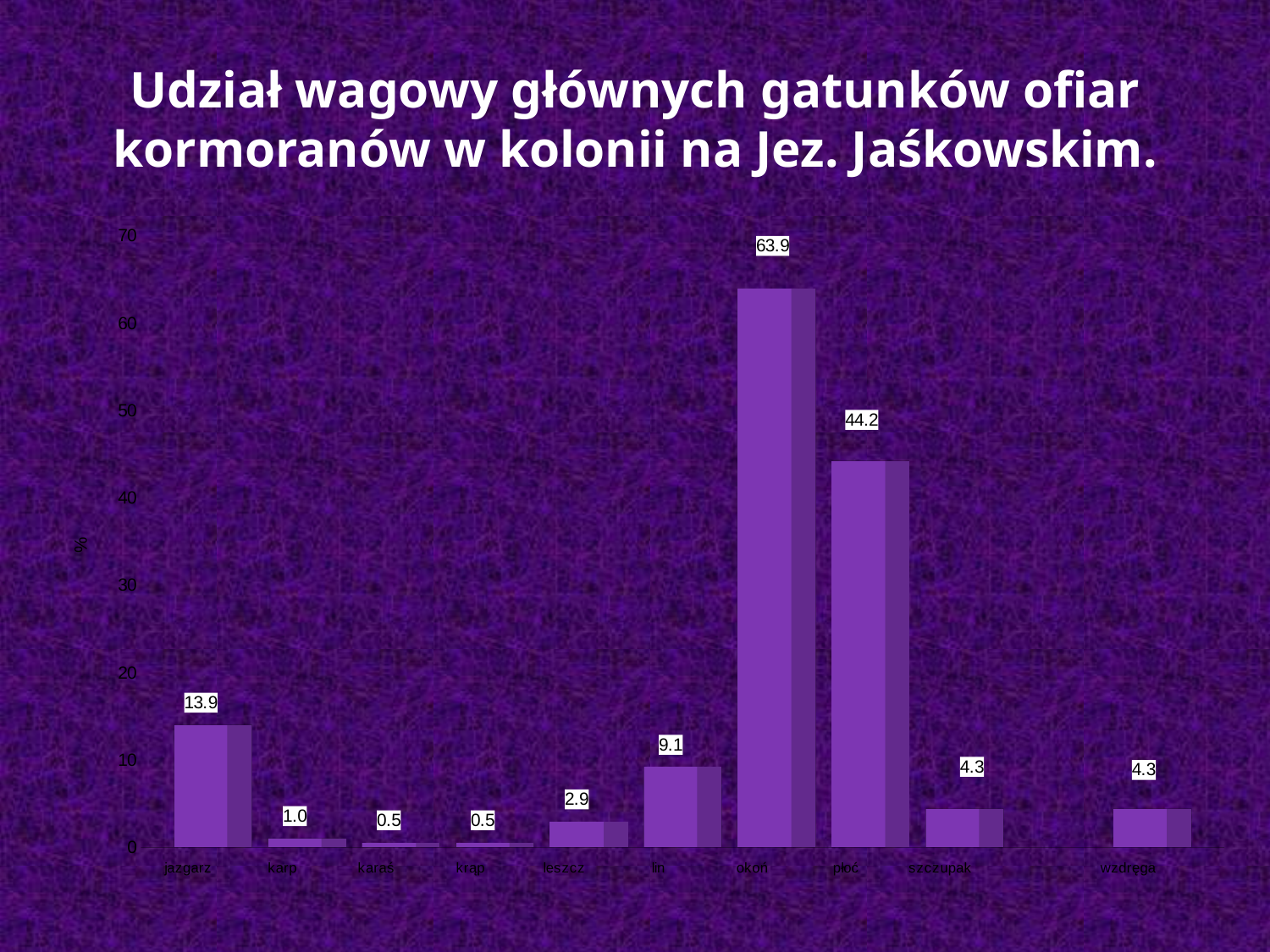
What is the value for leszcz? 2.9 What is the difference between the values for jazgarz and szczupak? 9.6 Which is larger, the value for jazgarz or the value for lin? jazgarz What is the value for okoń? 63.9 What is the value for płoć? 44.2 What is the value for jazgarz? 13.9 What type of chart is shown on the slide? bar chart Which category has the highest value? okoń What is the label on the vertical axis? % What is the difference between the values for okoń and płoć? 19.7 Is the value for płoć greater or less than 40? greater What is the value for lin? 9.1